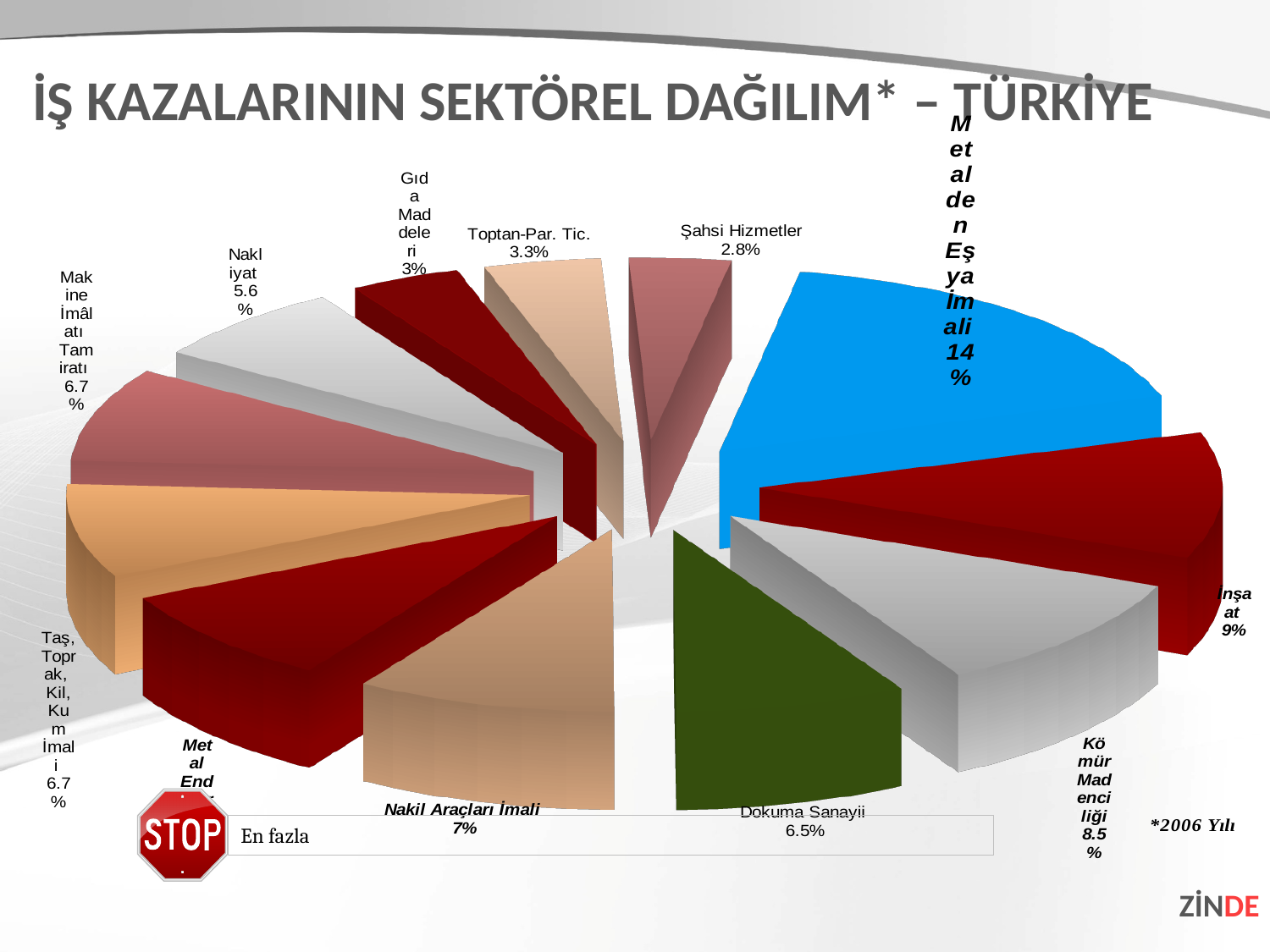
What percentage is shown for Nakliyat? 5.6% Which is larger, the share for Nakil Araçları İmali or the share for Dokuma Sanayii? Nakil Araçları İmali What kind of chart is shown on the slide? pie chart What percentage is shown for Kömür Madenciliği? 8.5% What share of work accidents is attributed to Metalden Eşya İmali? 14% What is the value shown for İnşaat? 9% Which sector has the largest share in the pie chart? Metalden Eşya İmali What is the value for Şahsi Hizmetler? 2.8% What is the value for Dokuma Sanayii? 6.5% Which year does the footnote say the data refers to? 2006 Which labeled sector has the smallest share in the pie chart? Şahsi Hizmetler What is the difference in percentage points between Metalden Eşya İmali and İnşaat? 5